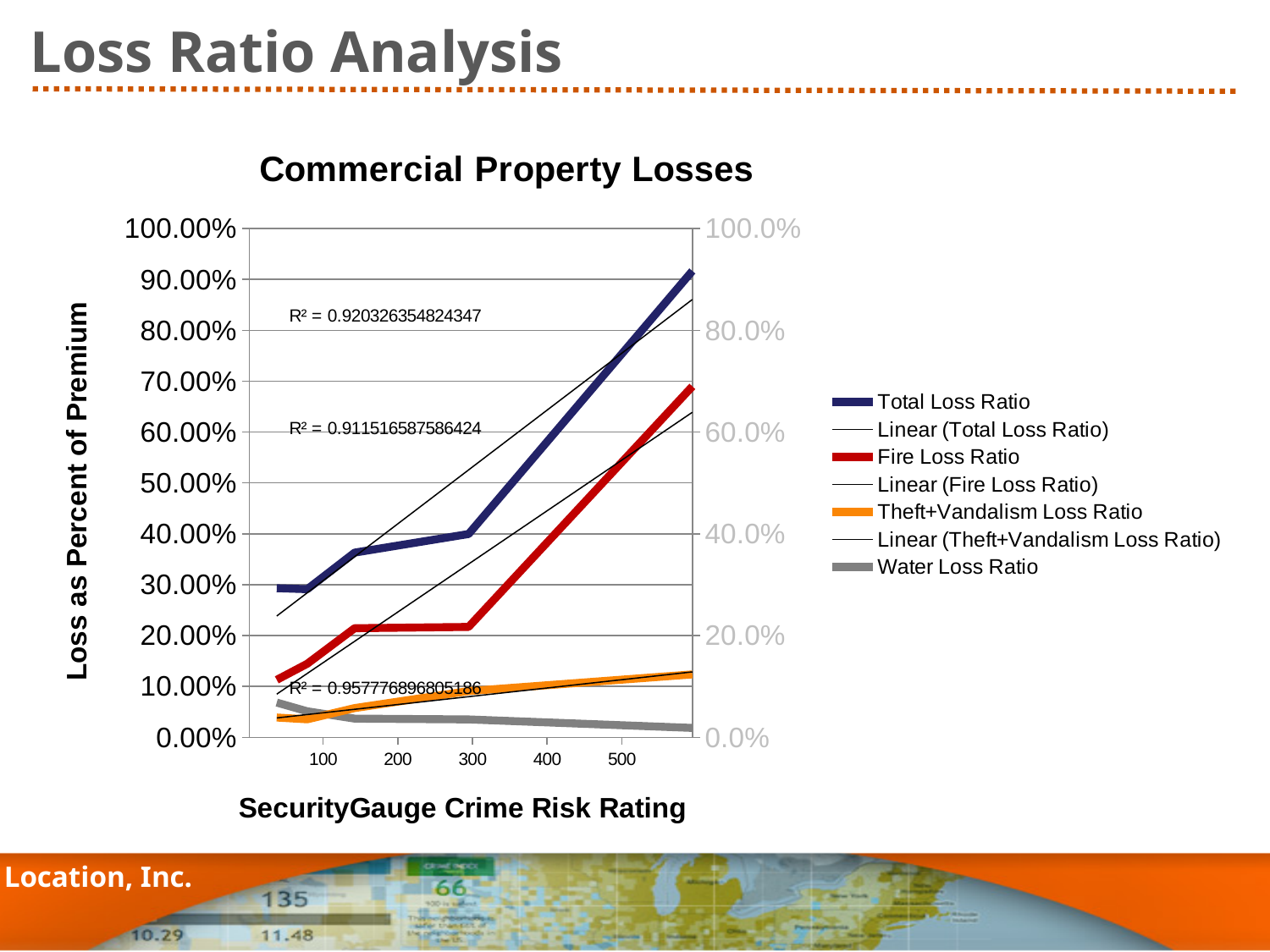
At a crime risk rating of 500, which is larger, the Fire Loss Ratio or the Theft+Vandalism Loss Ratio? Fire Loss Ratio Which series has the lowest value at the right end of the chart? Water Loss Ratio What is the label of the x axis? SecurityGauge Crime Risk Rating Is the Total Loss Ratio at the right end of the chart greater or less than 80.00%? greater Which series has the highest value at the right end of the chart? Total Loss Ratio Does the Total Loss Ratio rise or fall as the SecurityGauge Crime Risk Rating increases? Rise Does the Water Loss Ratio rise or fall as the SecurityGauge Crime Risk Rating increases? Fall How many series does the chart's legend list? 7 Is the Water Loss Ratio at a crime risk rating of 500 greater or less than 10.00%? less What type of chart is shown on the slide? Line chart Is the Fire Loss Ratio at the right end of the chart greater or less than 60.00%? greater What is the title of the chart? Commercial Property Losses